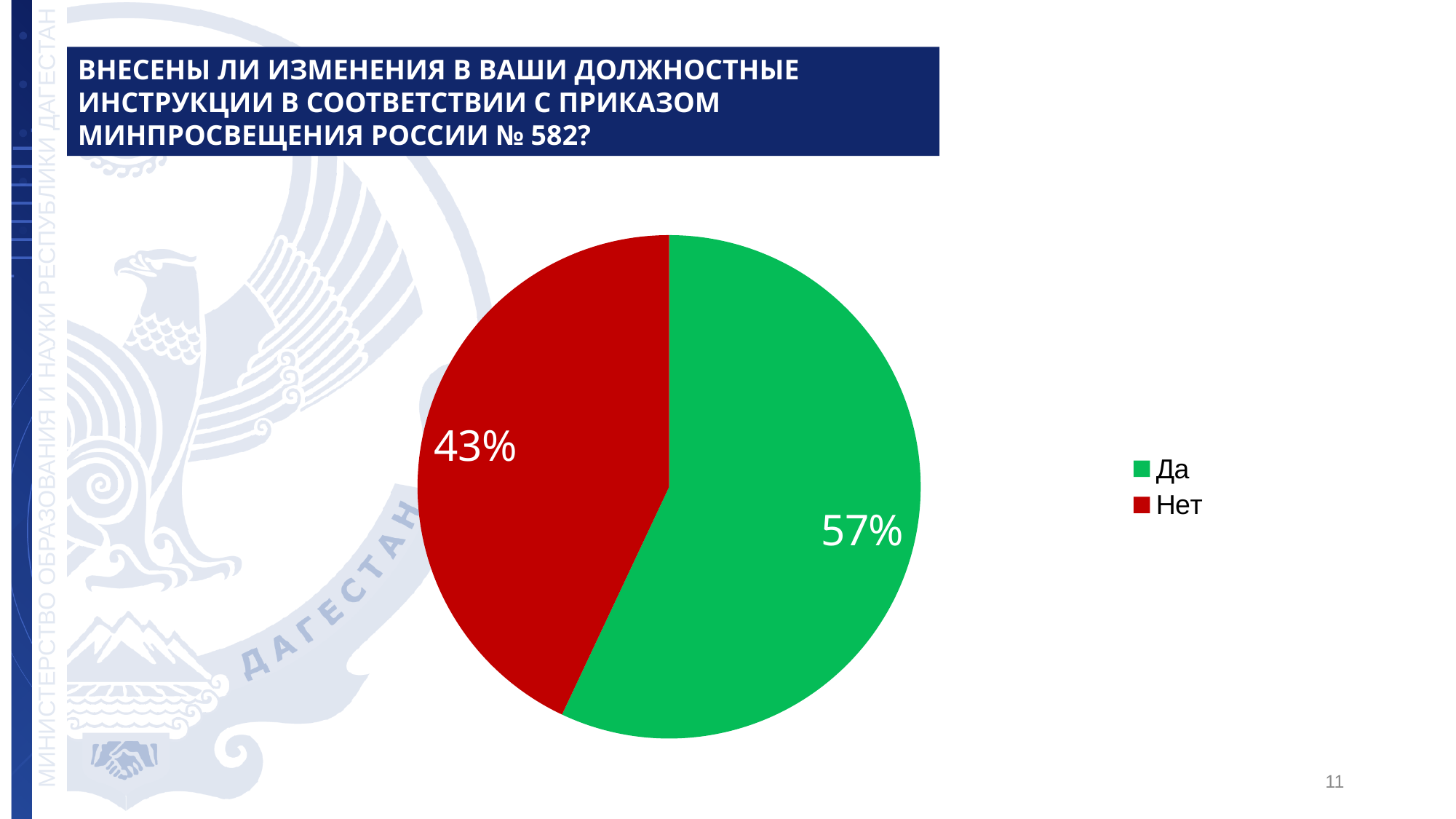
Which category has the smallest slice of the pie? Нет What kind of chart is shown on the slide? pie chart What is the difference in percentage points between "Да" and "Нет"? 14% How many slices does the pie chart have? 2 What share of the pie does "Да" represent? 57% What colour is the "Да" slice? green Which category has the largest slice of the pie? Да What share of the pie does "Нет" represent? 43% How many entries does the legend list? 2 What colour is the "Нет" slice? red Which is larger, the share for "Да" or the share for "Нет"? Да